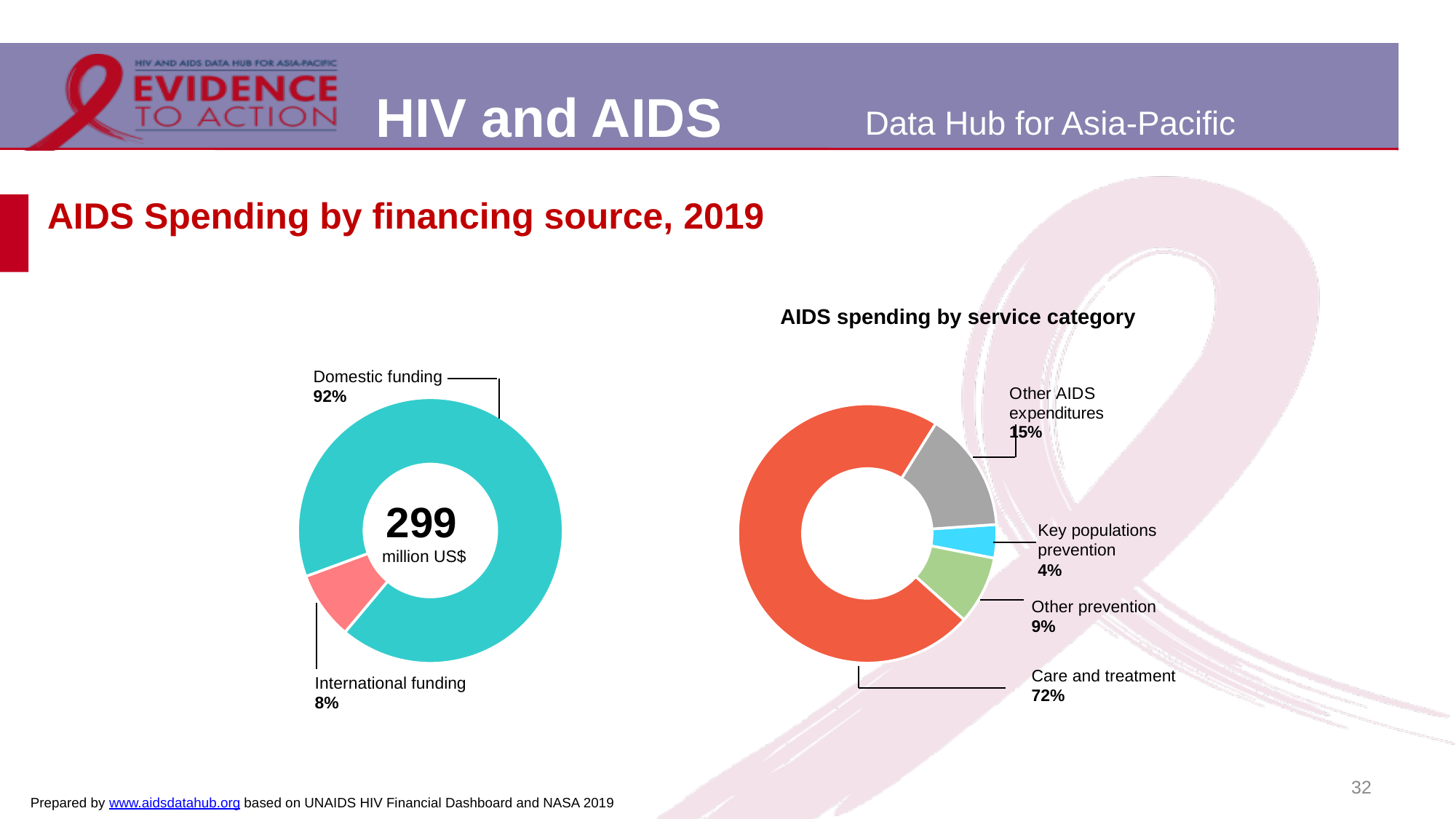
In the left donut chart (AIDS spending by financing source), what total value is shown in the centre? 299 million US$ In the right chart (AIDS spending by service category), what share is Other AIDS expenditures? 15% In the left donut chart (AIDS spending by financing source), what share is International funding? 8% In the right chart (AIDS spending by service category), which is larger: Other prevention or Other AIDS expenditures? Other AIDS expenditures In the left donut chart (AIDS spending by financing source), what is the difference in percentage points between Domestic funding and International funding? 84 percentage points What type of chart is used for AIDS spending by service category? Donut (pie) chart In the right chart (AIDS spending by service category), how many service categories are shown? 4 In the right chart (AIDS spending by service category), which service category has the smallest share? Key populations prevention In the right chart (AIDS spending by service category), what share is Care and treatment? 72% In the right chart (AIDS spending by service category), what share is Key populations prevention? 4% In the left donut chart (AIDS spending by financing source), which financing source has the larger share? Domestic funding In the left donut chart (AIDS spending by financing source), what share is Domestic funding? 92%